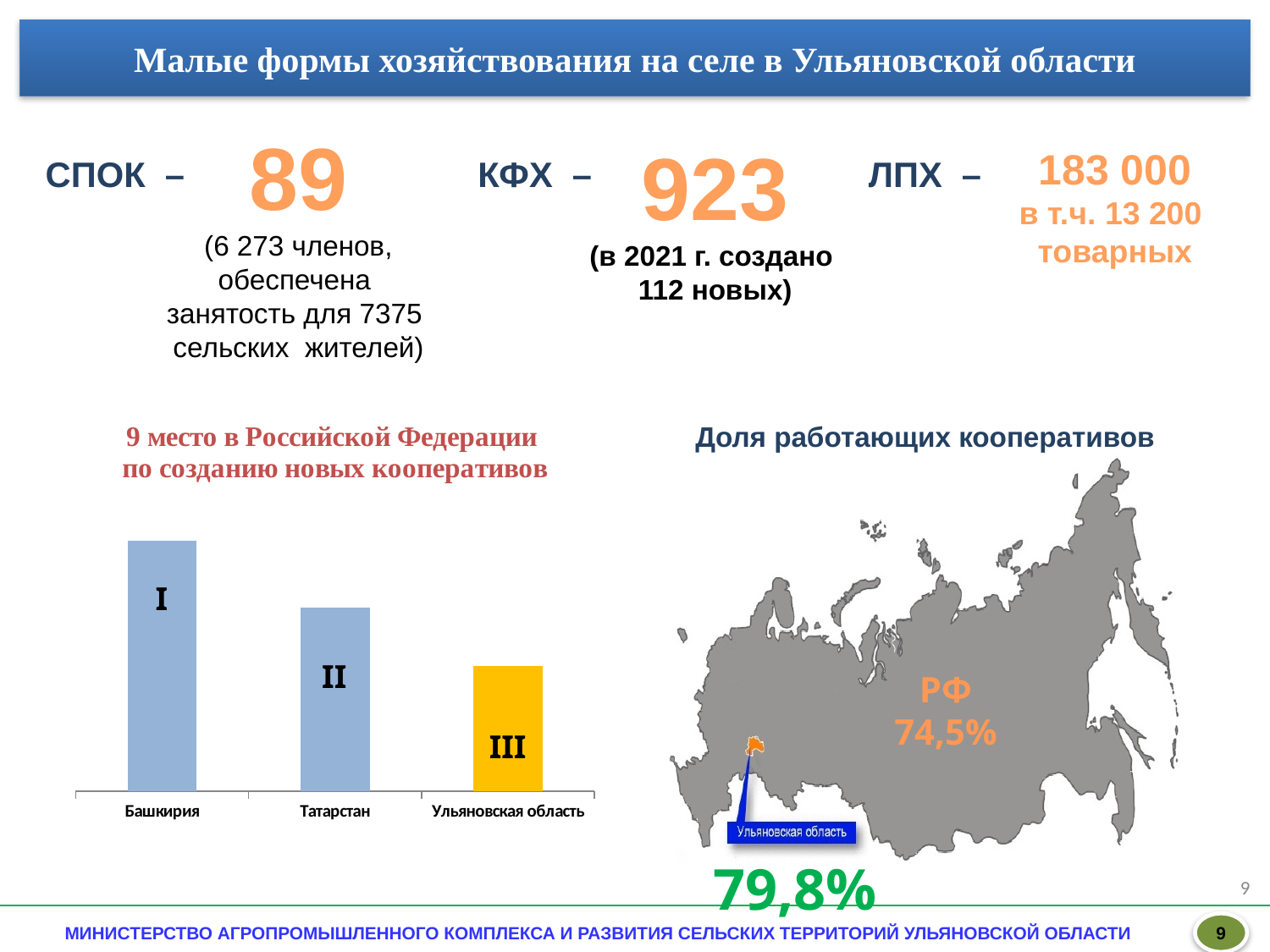
Which category has the tallest bar in the bar chart? Башкирия What label is printed on the bar for Башкирия? I What label is printed on the bar for Ульяновская область? III In the bar chart, which bar is taller: Башкирия or Татарстан? Башкирия Which category has the shortest bar in the bar chart? Ульяновская область In the bar chart, which bar is taller: Татарстан or Ульяновская область? Татарстан Do the bar heights rise or fall from left to right across the x axis? Fall Which category's bar carries the label "II"? Татарстан What is the heading above the bar chart? 9 место в Российской Федерации по созданию новых кооперативов How many categories are shown on the x axis of the bar chart? 3 What colour is the bar for Ульяновская область? Yellow What kind of chart is shown on the left of the slide under the heading "9 место в Российской Федерации по созданию новых кооперативов"? Bar chart